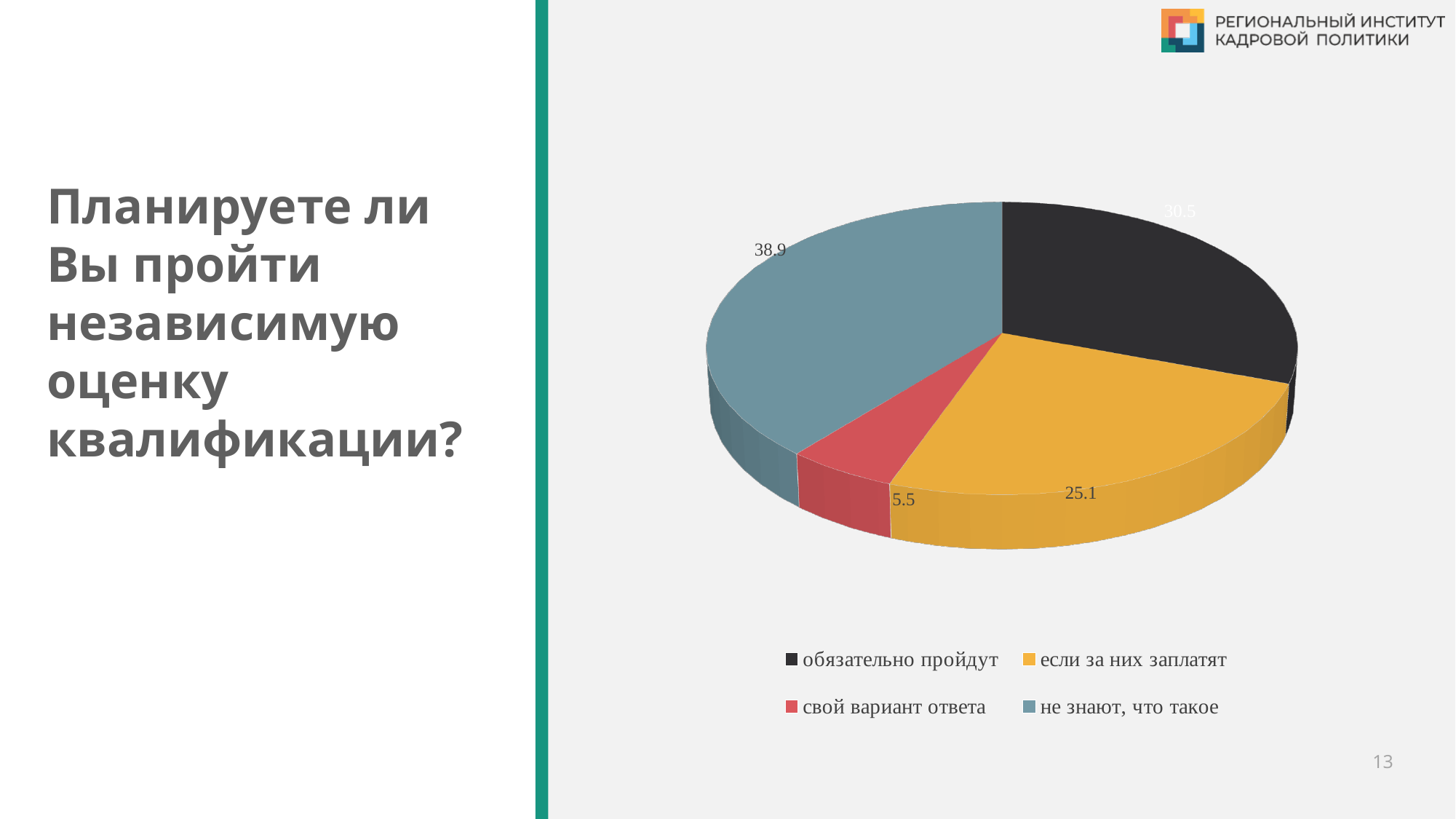
What is the value for "обязательно пройдут"? 30.5 Which category has the largest slice? не знают, что такое What kind of chart is shown on the slide? pie chart Which category has the smallest slice? свой вариант ответа What is the value for "не знают, что такое"? 38.9 What is the value for "если за них заплатят"? 25.1 Which is larger: "обязательно пройдут" or "если за них заплатят"? обязательно пройдут How many slices does the pie chart have? 4 What is the value for "свой вариант ответа"? 5.5 What colour is the slice for "свой вариант ответа"? red What is the difference between the values for "не знают, что такое" and "обязательно пройдут"? 8.4 How many entries does the legend list? 4